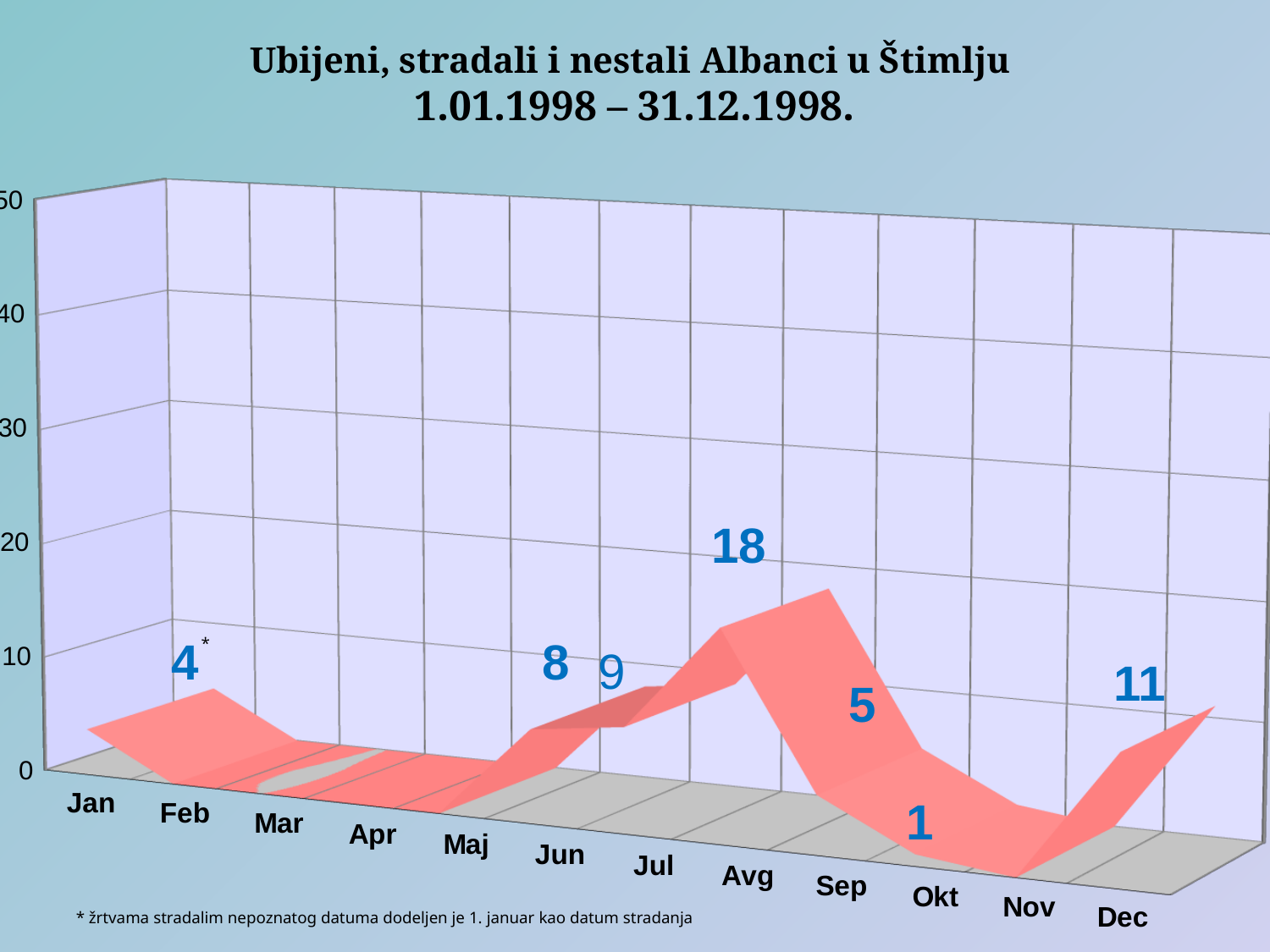
What kind of chart is this? 3D line chart How many months are shown on the x axis? 12 Do the values rise or fall from Avg to Okt? fall Is the value for Nov greater or less than 10? less Which is larger, the value for Jul or the value for Dec? Dec Which month has the highest value? Avg What is the value for Jan? 4 What is the value for Sep? 5 What is the value for Dec? 11 What is the difference between the values for Avg and Dec? 7 What is the value for Avg? 18 What is the difference between the values for Avg and Sep? 13